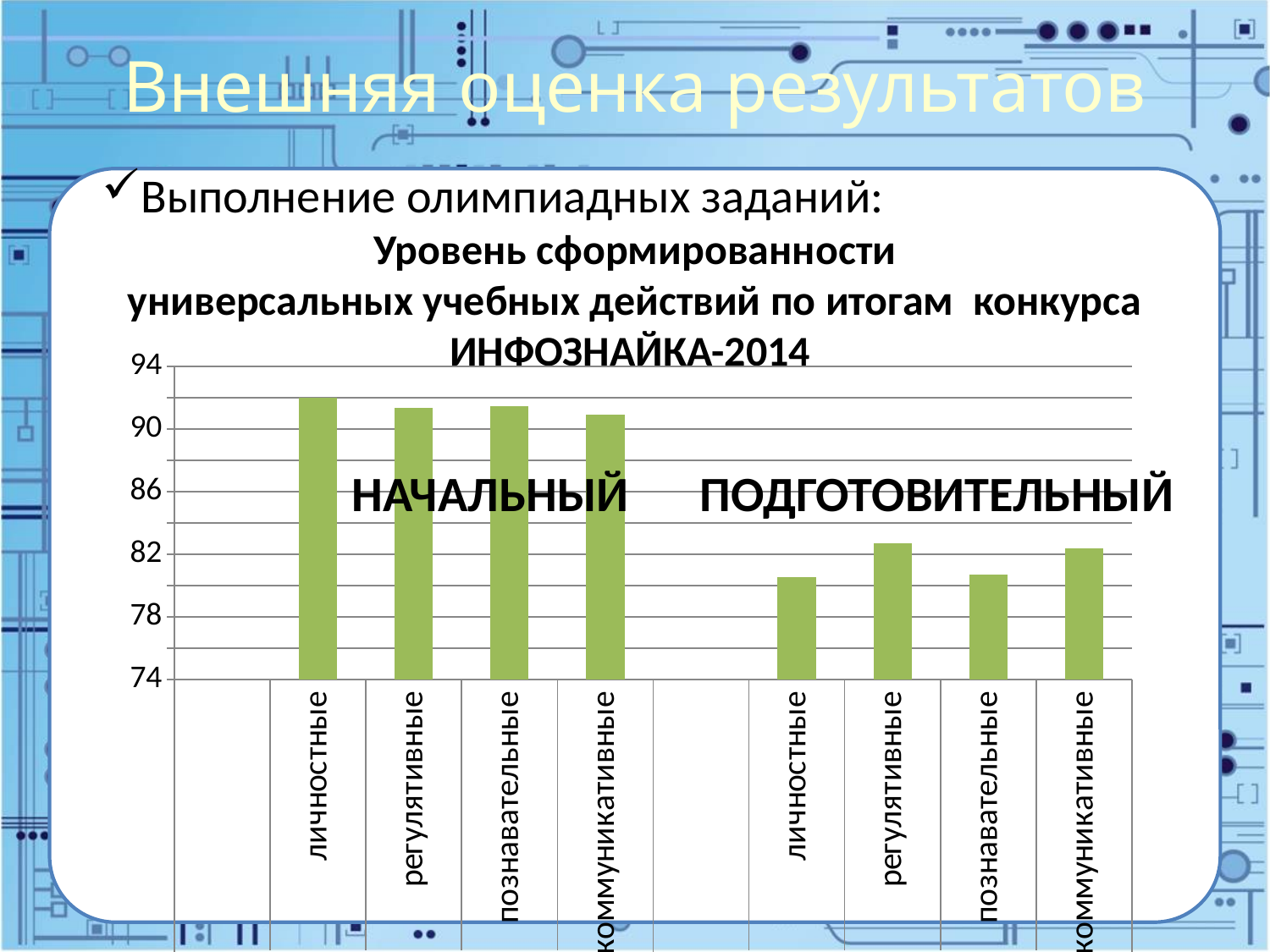
Is the value for регулятивные in the ПОДГОТОВИТЕЛЬНЫЙ group greater or less than 86? less Is the value for коммуникативные in the НАЧАЛЬНЫЙ group greater or less than 86? greater Is the value for познавательные in the ПОДГОТОВИТЕЛЬНЫЙ group greater or less than 78? greater What kind of chart is shown on the slide? bar chart What colour are the bars in the chart? green How many bars are plotted in the chart? 8 What is the lowest value shown on the vertical axis? 74 Which is larger: личностные in the НАЧАЛЬНЫЙ group or личностные in the ПОДГОТОВИТЕЛЬНЫЙ group? личностные in the НАЧАЛЬНЫЙ group Which is larger: регулятивные in the ПОДГОТОВИТЕЛЬНЫЙ group or познавательные in the ПОДГОТОВИТЕЛЬНЫЙ group? регулятивные What are the two group labels written inside the chart area? НАЧАЛЬНЫЙ and ПОДГОТОВИТЕЛЬНЫЙ